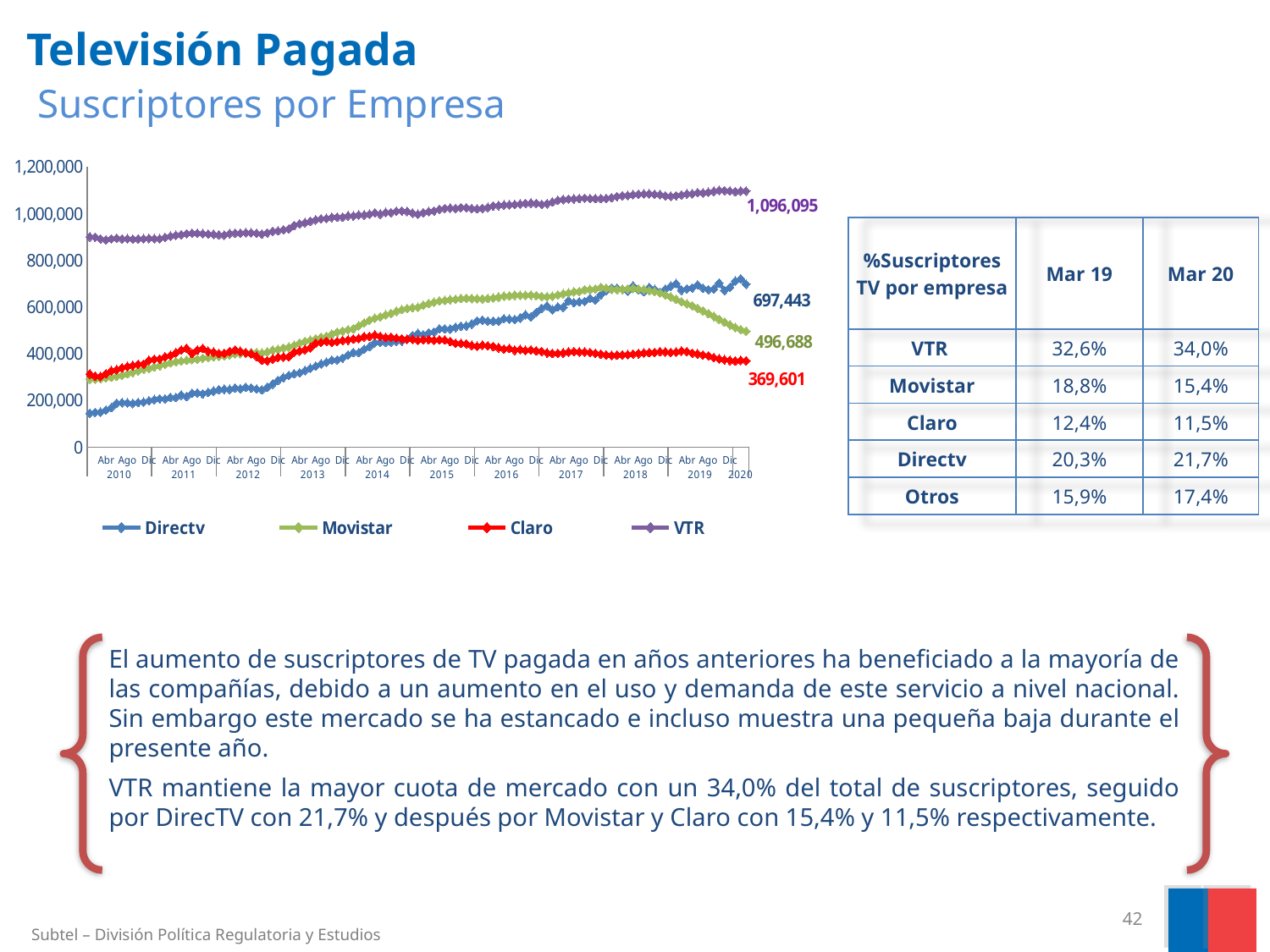
Does the VTR series generally rise or fall from 2010 to 2020? rise What is the final labelled value for Directv on the chart? 697,443 What is the difference between the final labelled values of VTR and Directv? 398,652 What is the final labelled value for VTR on the chart? 1,096,095 Which series has the highest value at the end of the chart? VTR How many series does the chart legend list? 4 Is the value for Directv at the start of the chart in 2010 greater or less than 200,000? less What is the final labelled value for Claro on the chart? 369,601 At the end of the chart, which is larger: the value for Movistar or the value for Claro? Movistar What type of chart is shown on the slide? line chart Which series has the lowest value at the end of the chart? Claro What is the final labelled value for Movistar on the chart? 496,688